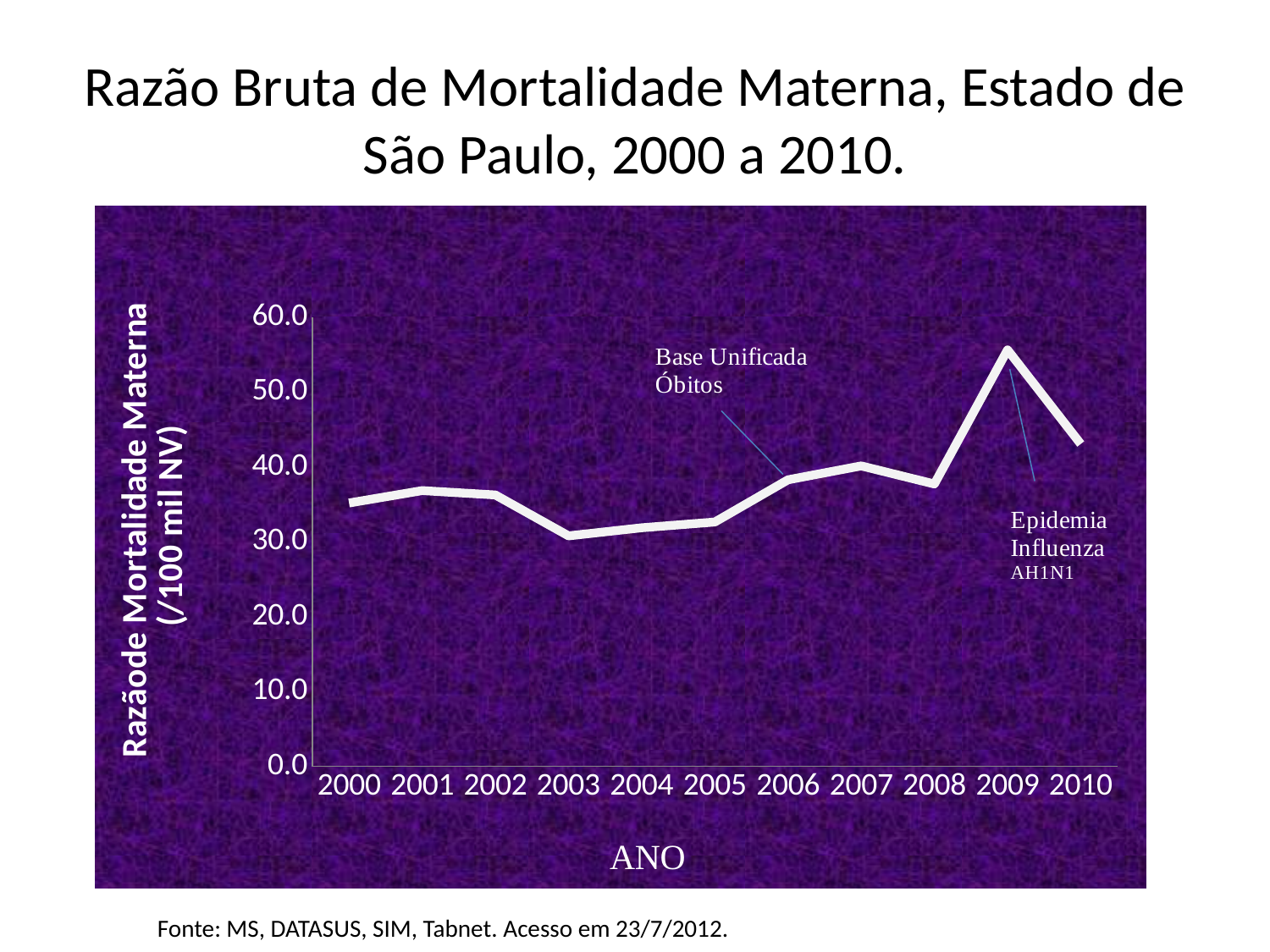
Is the value for 2009 greater or less than 50.0? greater Does the line rise or fall from 2009 to 2010? fall Which year has the larger value, 2003 or 2006? 2006 What kind of chart is shown on the slide? line chart Which year has the larger value, 2009 or 2010? 2009 Is the value for 2000 greater or less than 30.0? greater What event is annotated at the 2009 peak of the line? Epidemia Influenza AH1N1 Is the value for 2003 greater or less than 40.0? less Which year has the lowest maternal mortality ratio? 2003 How many years are plotted along the x axis? 11 Which year has the highest maternal mortality ratio? 2009